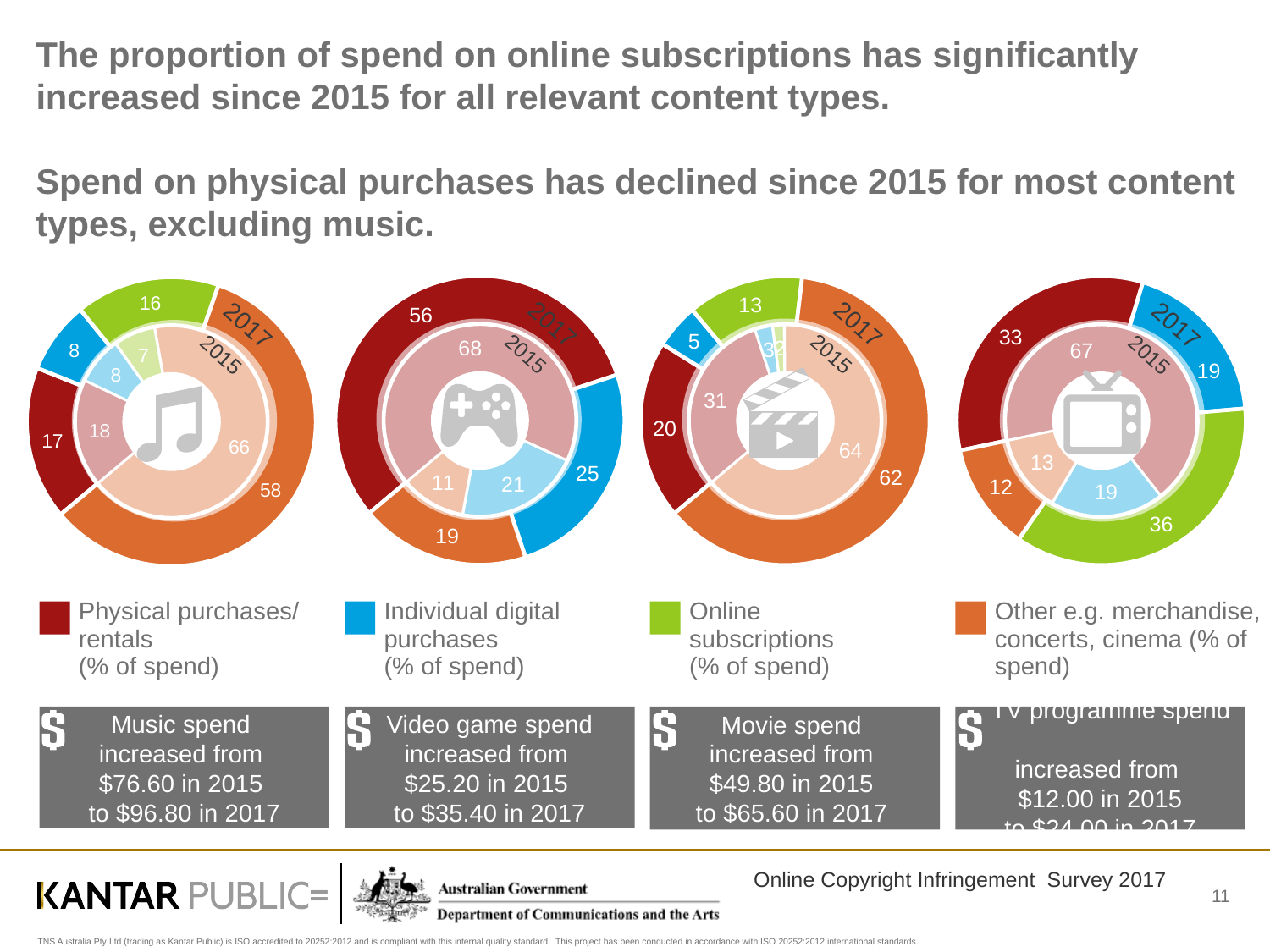
In the music chart (first from left), what is the 2015 value for Online subscriptions? 7 What kind of charts are shown on the slide? Donut (pie) charts In the TV programme chart (fourth from left), what is the 2015 value for Physical purchases/rentals? 67 How many series does the legend list? 4 In the video game chart (second from left), which category has the highest share in 2015? Physical purchases/rentals In the music chart (first from left), what is the 2017 value for Other e.g. merchandise, concerts, cinema? 58 In the movie chart (third from left), what is the 2017 value for Online subscriptions? 13 In the video game chart (second from left), what is the difference between the 2015 and 2017 Physical purchases/rentals values? 12 In the music chart (first from left), by how much did the Online subscriptions share change from 2015 to 2017? 9 In the TV programme chart (fourth from left), which category has the highest share in 2017? Online subscriptions In the movie chart (third from left), which is larger in 2017: Physical purchases/rentals or Individual digital purchases? Physical purchases/rentals In the video game chart (second from left), what is the 2017 value for Physical purchases/rentals? 56